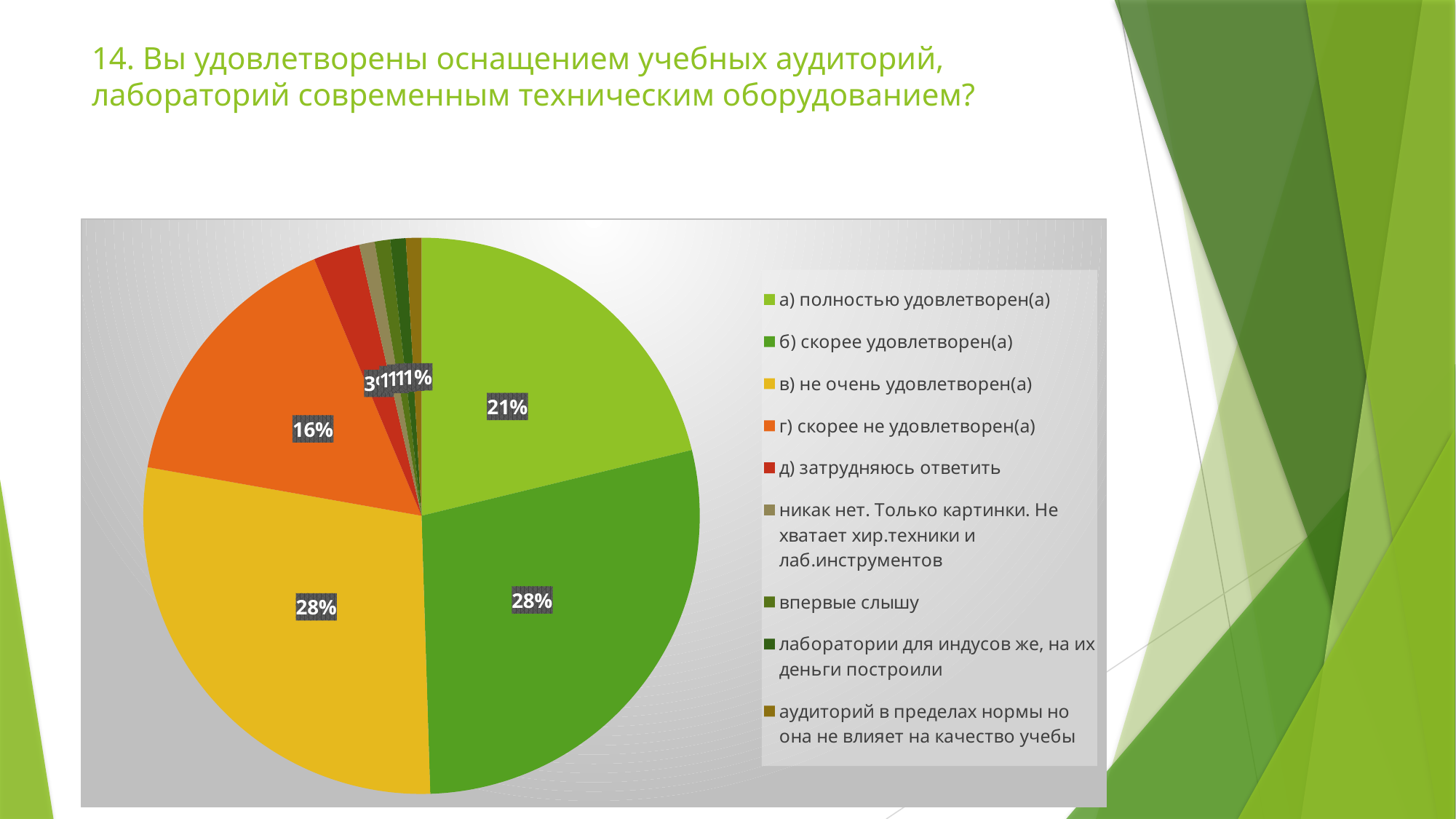
How many entries does the chart legend list? 9 What percentage of the pie chart is the slice for "в) не очень удовлетворен(а)"? 28% What kind of chart is shown on the slide? pie chart What is the difference in percentage points between the slices for "а) полностью удовлетворен(а)" and "г) скорее не удовлетворен(а)"? 5 percentage points Which slice is larger: "б) скорее удовлетворен(а)" or "а) полностью удовлетворен(а)"? б) скорее удовлетворен(а) Which slice is larger: "а) полностью удовлетворен(а)" or "г) скорее не удовлетворен(а)"? а) полностью удовлетворен(а) What percentage of the pie chart is the slice for "б) скорее удовлетворен(а)"? 28% What survey question number is shown in the slide title? 14 What is the difference in percentage points between the slices for "б) скорее удовлетворен(а)" and "а) полностью удовлетворен(а)"? 7 percentage points What is the combined share of the slices "а) полностью удовлетворен(а)" and "б) скорее удовлетворен(а)"? 49% What percentage of the pie chart is the slice for "г) скорее не удовлетворен(а)"? 16% What percentage of the pie chart is the slice for "а) полностью удовлетворен(а)"? 21%